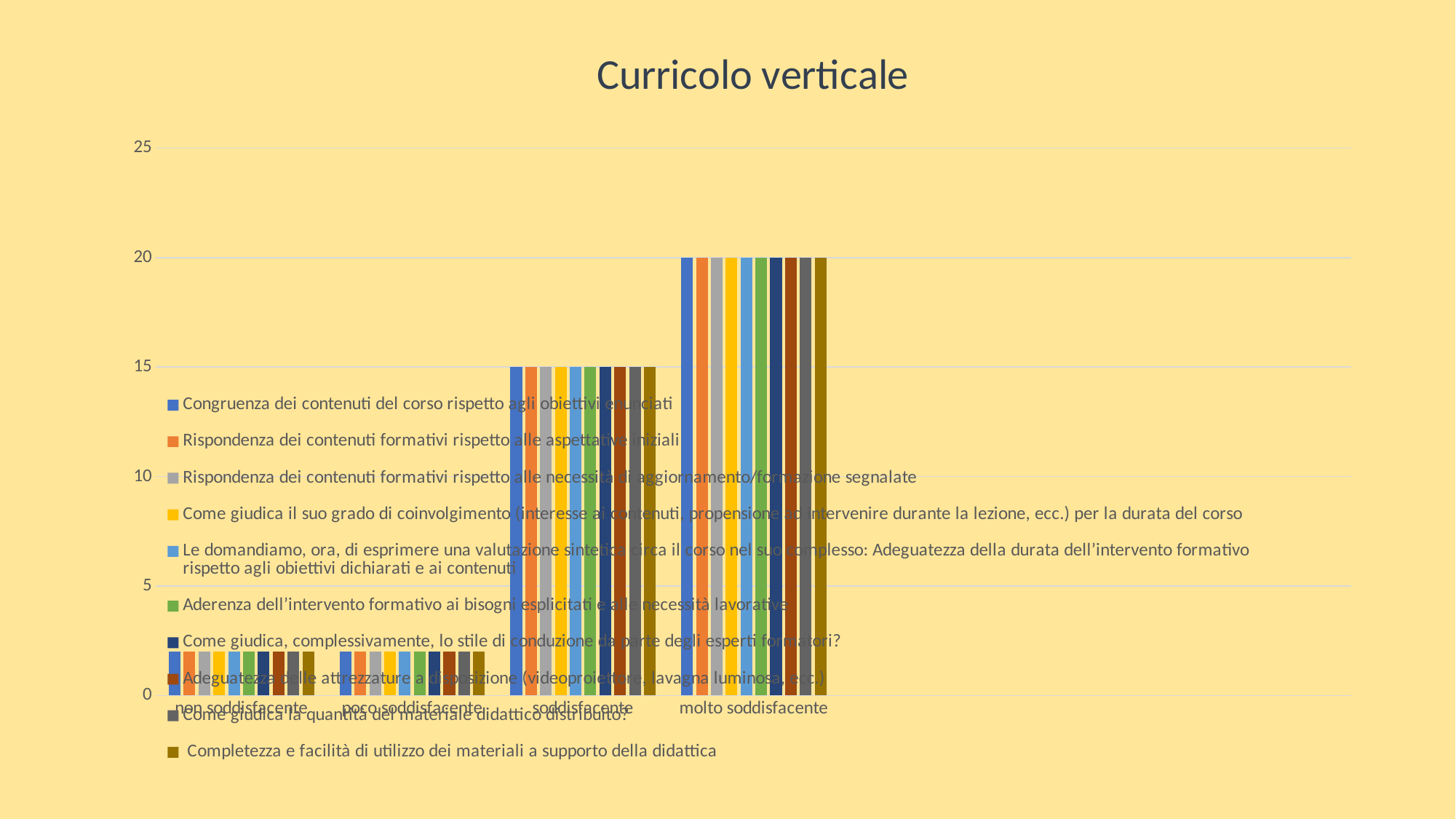
Which category has the highest values? molto soddisfacente How many series does the legend list? 10 What is the value for 'molto soddisfacente' for the series 'Congruenza dei contenuti del corso rispetto agli obiettivi enunciati'? 20 What is the title of the chart? Curricolo verticale What kind of chart is shown on the slide? bar chart How many categories are shown on the x axis? 4 Which is larger, the value for 'soddisfacente' or the value for 'poco soddisfacente'? soddisfacente What is the value for 'soddisfacente' for the series 'Completezza e facilità di utilizzo dei materiali a supporto della didattica'? 15 Do the values rise or fall from 'non soddisfacente' to 'molto soddisfacente' along the x axis? rise Is the value for 'poco soddisfacente' greater or less than 5? less Is the value for 'non soddisfacente' greater or less than 5? less What is the difference between the 'molto soddisfacente' and 'soddisfacente' values for the series 'Rispondenza dei contenuti formativi rispetto alle aspettative iniziali'? 5